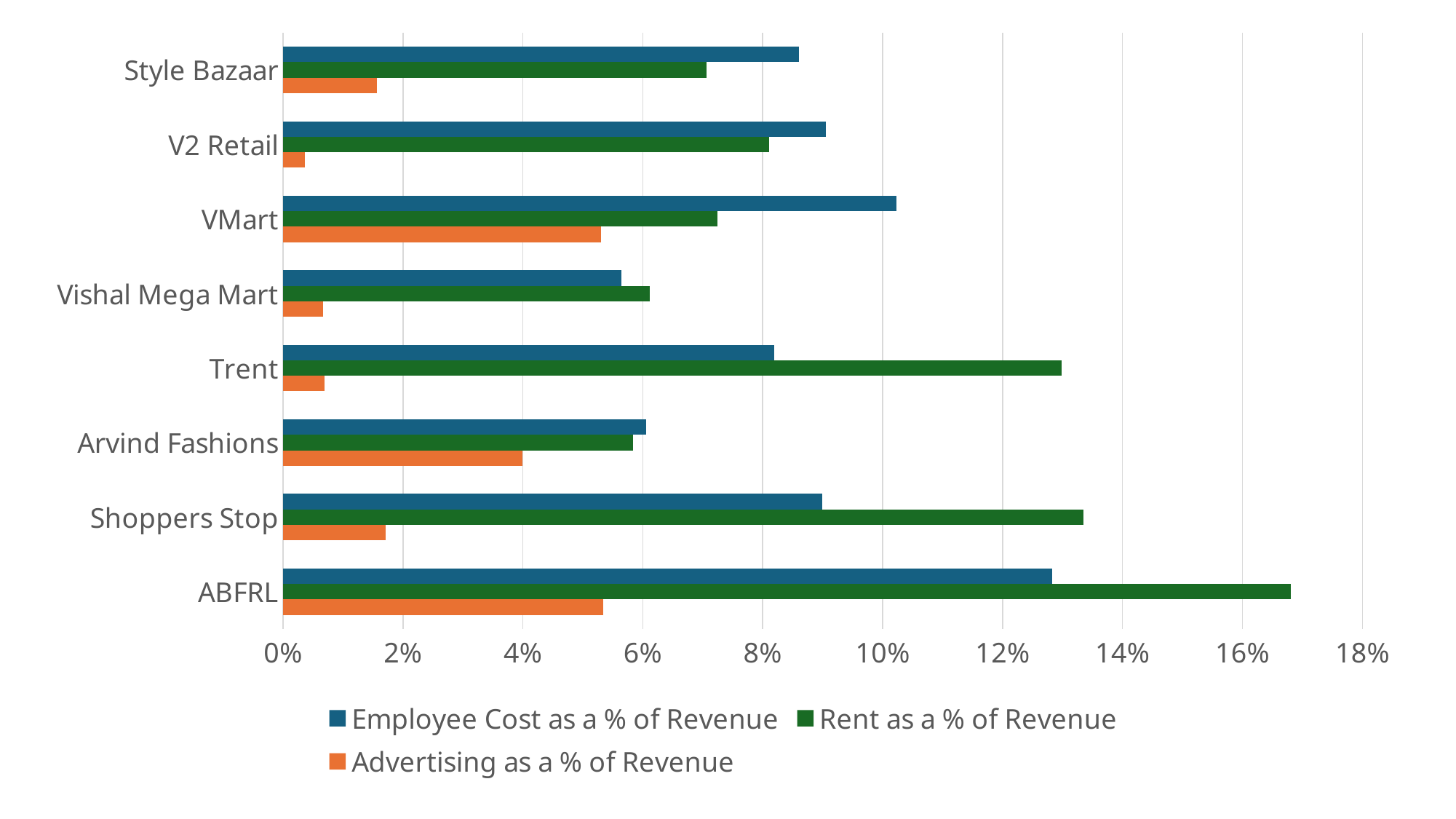
Is the Employee Cost as a % of Revenue for Style Bazaar greater or less than 8%? greater What kind of chart is shown on the slide? bar chart Which company has the highest Rent as a % of Revenue? ABFRL How many companies are shown on the chart? 8 Which company has the highest Employee Cost as a % of Revenue? ABFRL Which series is shown in orange in the legend? Advertising as a % of Revenue Is the Rent as a % of Revenue for ABFRL greater or less than 16%? greater Which company has the lowest Advertising as a % of Revenue? V2 Retail Is the Rent as a % of Revenue for Trent greater or less than 12%? greater For Shoppers Stop, which is larger: Employee Cost as a % of Revenue or Rent as a % of Revenue? Rent as a % of Revenue How many series does the legend list? 3